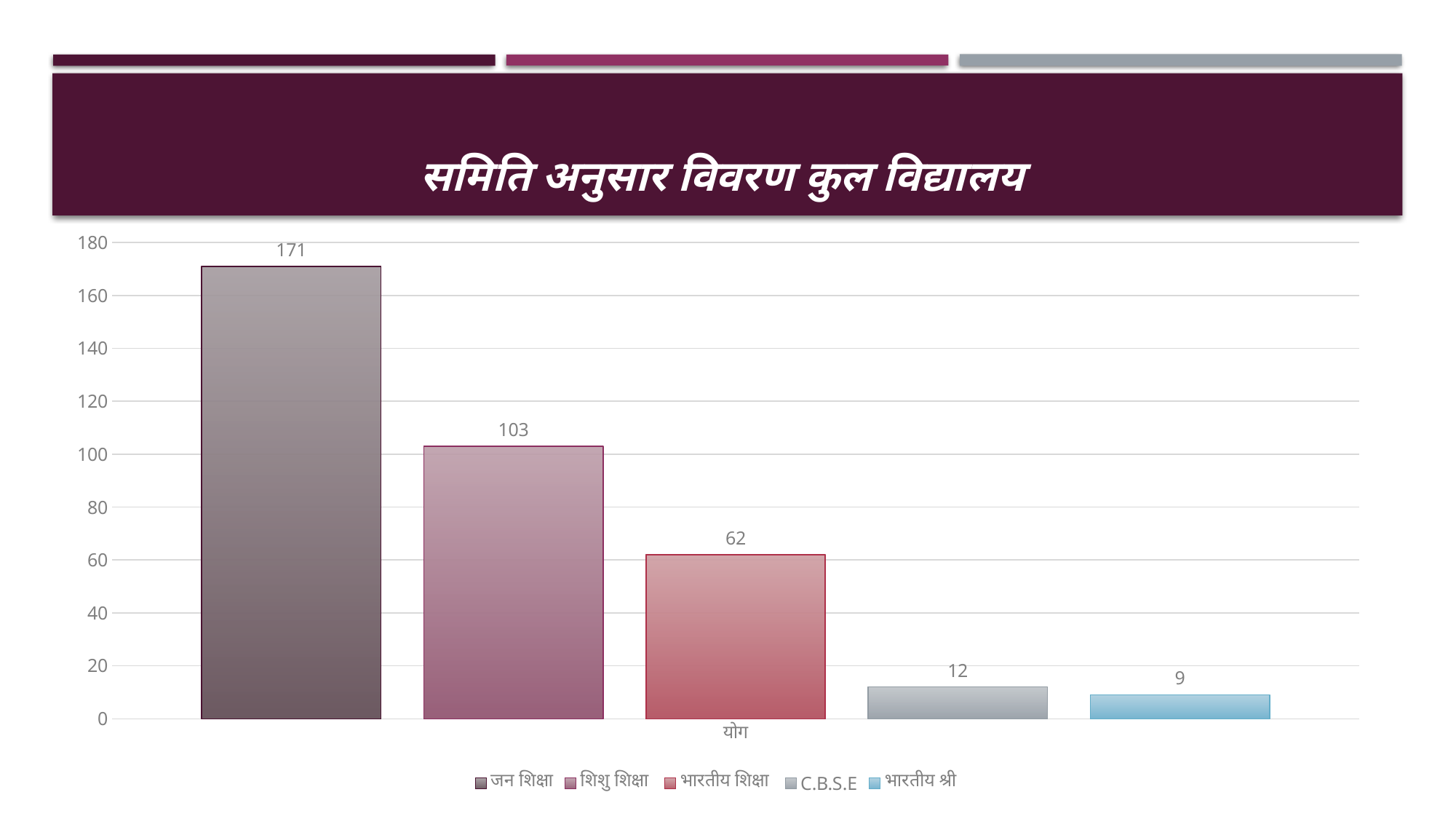
What is the value for C.B.S.E? 12 What is the difference between the values for जन शिक्षा and शिशु शिक्षा? 68 Which series has the highest value? जन शिक्षा What is the value for भारतीय श्री? 9 Which is larger, the value for भारतीय शिक्षा or the value for C.B.S.E? भारतीय शिक्षा What is the value for भारतीय शिक्षा? 62 What kind of chart is shown on the slide? Bar chart What is the value for शिशु शिक्षा? 103 How many series does the legend list? 5 What is the value for जन शिक्षा? 171 What is the title of the chart? समिति अनुसार विवरण कुल विद्यालय Which series has the lowest value? भारतीय श्री